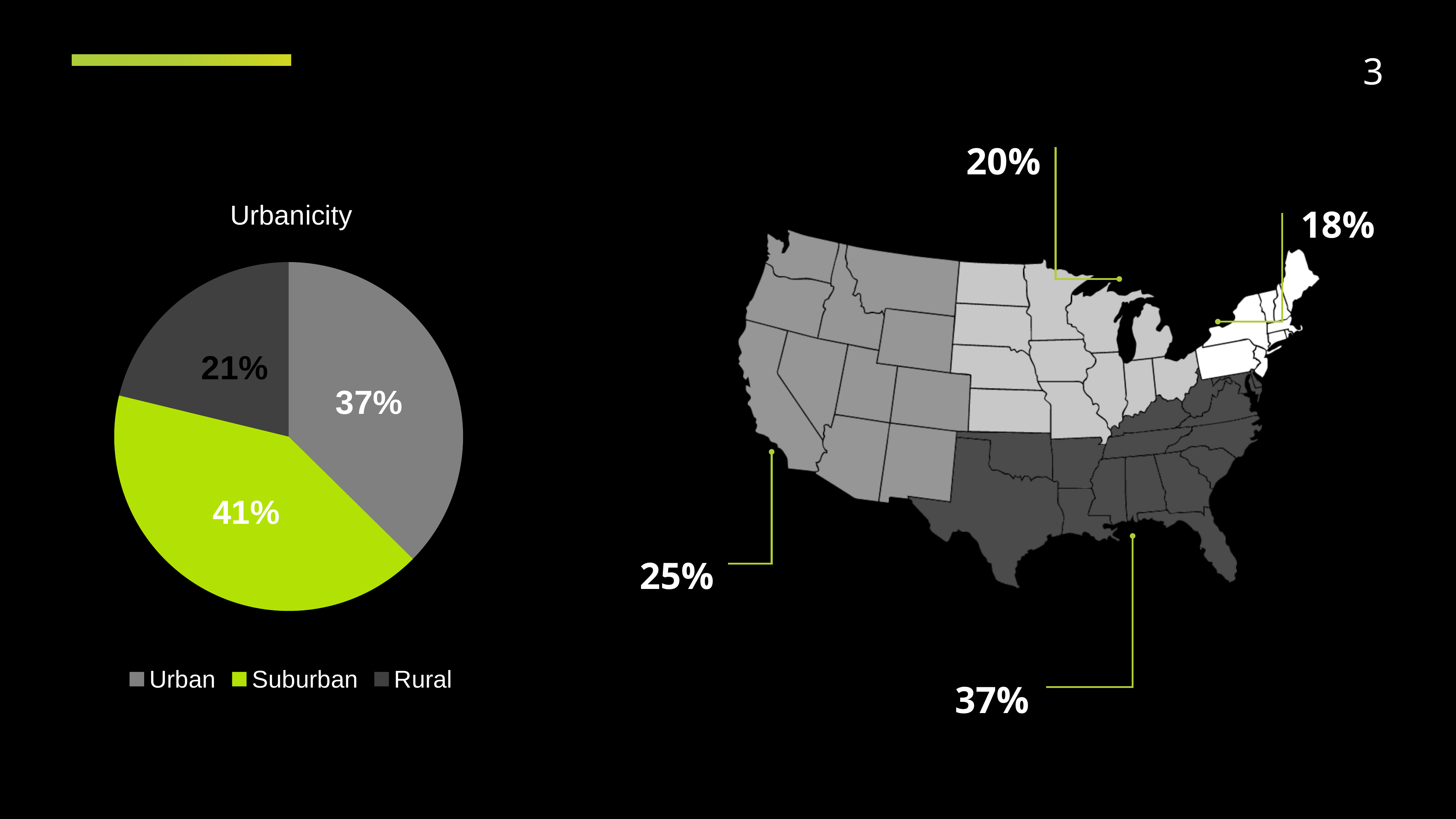
How many categories does the Urbanicity pie chart show? 3 In the Urbanicity pie chart, which category has the largest share? Suburban In the Urbanicity pie chart, what percentage is Suburban? 41% In the Urbanicity pie chart, what percentage is Rural? 21% On the US map on the right, what is the highest percentage shown? 37% In the Urbanicity pie chart, what is the difference between the Suburban and Rural shares? 20% What kind of chart is the Urbanicity chart? Pie chart What is the title of the pie chart on the left of the slide? Urbanicity In the Urbanicity pie chart, which category is shown in green? Suburban In the Urbanicity pie chart, what percentage is Urban? 37% In the Urbanicity pie chart, which category has the smallest share? Rural In the Urbanicity pie chart, which is larger, Urban or Rural? Urban